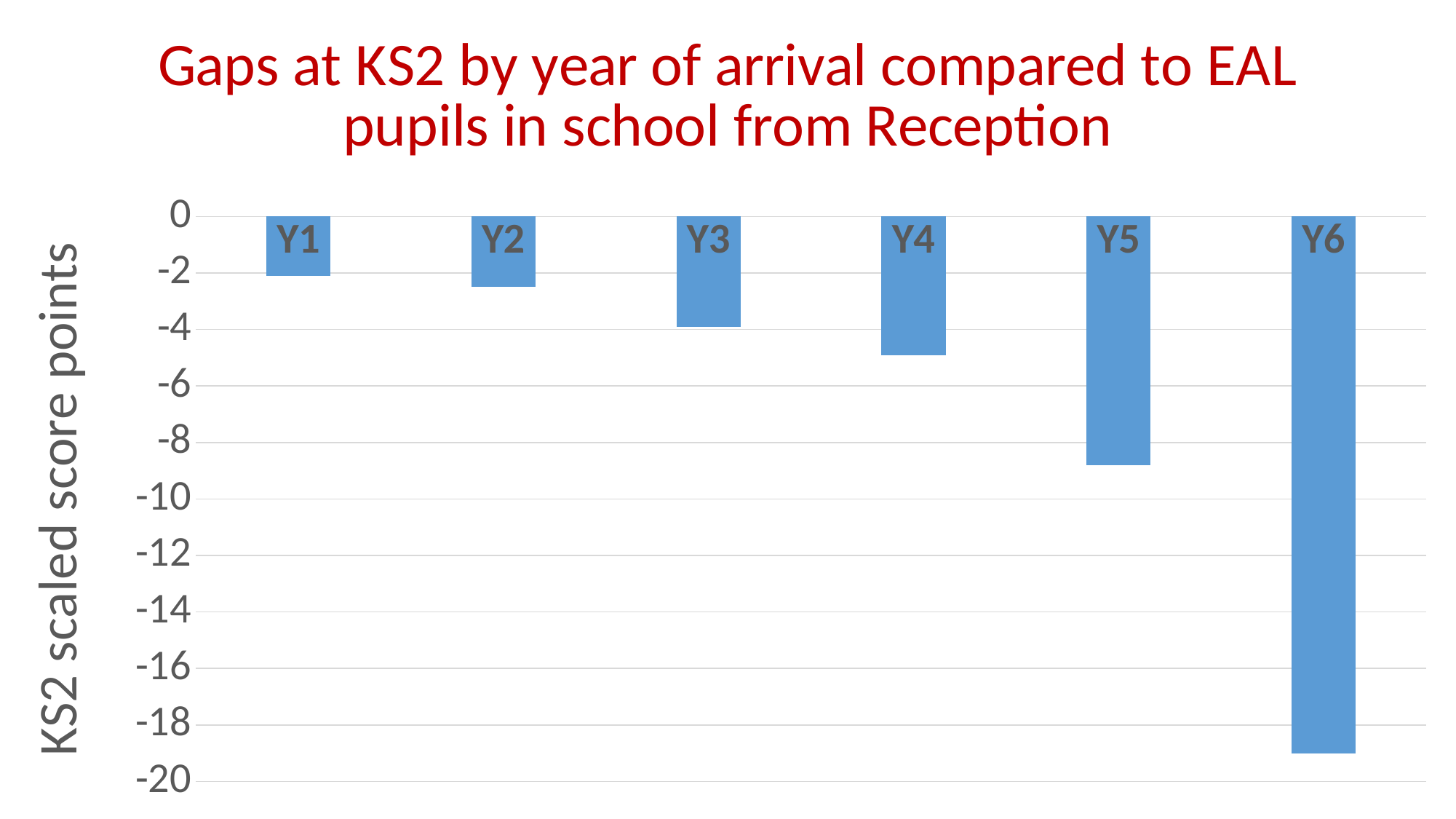
Is the value for Y6 greater or less than -18? less Is the value for Y5 greater or less than -10? greater Do the values rise or fall as you move from Y1 to Y6 along the x axis? fall Is the value for Y2 greater or less than -4? greater What is the label on the vertical axis of the chart? KS2 scaled score points How many year-of-arrival categories are plotted on the chart? 6 What is the title of the chart? Gaps at KS2 by year of arrival compared to EAL pupils in school from Reception Which has the larger (less negative) value, Y4 or Y5? Y4 Which year of arrival has the lowest (most negative) value on the chart? Y6 What kind of chart is shown on the slide? bar chart